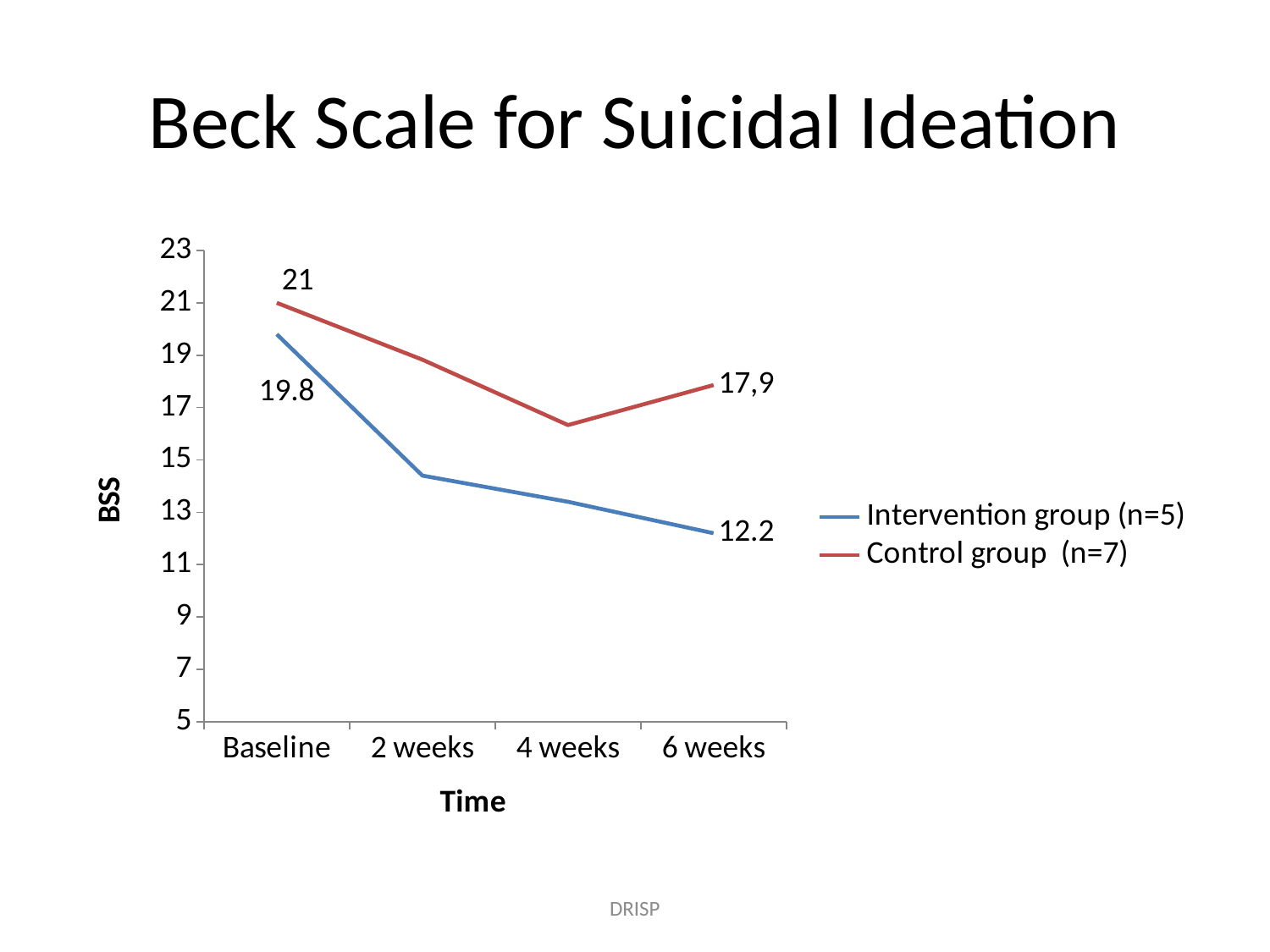
Is the value for the Intervention group (n=5) at 2 weeks greater or less than 15? less What is the value for the Intervention group (n=5) at 6 weeks? 12.2 What kind of chart is shown on the slide? Line chart What is the value for the Control group (n=7) at Baseline? 21 What is the title of the y axis? BSS At Baseline, which group has the higher BSS value? Control group (n=7) How many time points are shown on the x axis? 4 What is the value for the Intervention group (n=5) at Baseline? 19.8 Does the Intervention group (n=5) line rise or fall from Baseline to 6 weeks? Fall How many series does the legend list? 2 What is the value for the Control group (n=7) at 6 weeks? 17,9 By how much did the Intervention group (n=5) value fall from Baseline to 6 weeks? 7.6